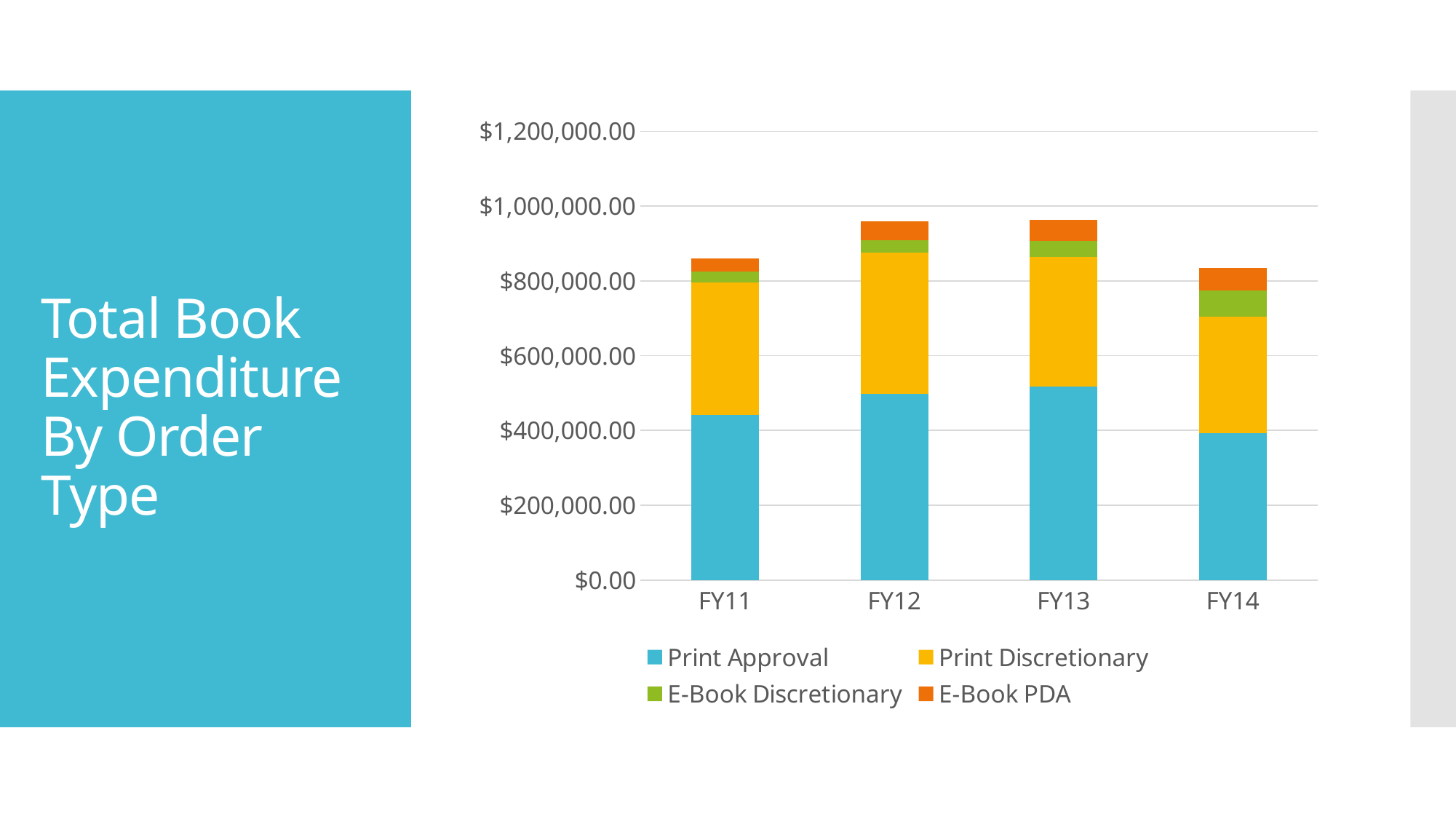
What kind of chart is shown on the slide? Stacked bar chart How many fiscal years are shown on the x axis of the chart? 4 How many series does the chart legend list? 4 Which fiscal year has the highest E-Book Discretionary value? FY14 Is the Print Approval value for FY12 greater or less than $400,000.00? greater Is the total stacked value for FY11 greater or less than $800,000.00? greater Is the Print Approval value for FY13 greater or less than $600,000.00? less Which series is shown in blue in the chart? Print Approval What is the title of the slide containing the chart? Total Book Expenditure By Order Type Which is larger, the Print Approval value for FY11 or for FY14? FY11 Which fiscal year has the lowest Print Approval value? FY14